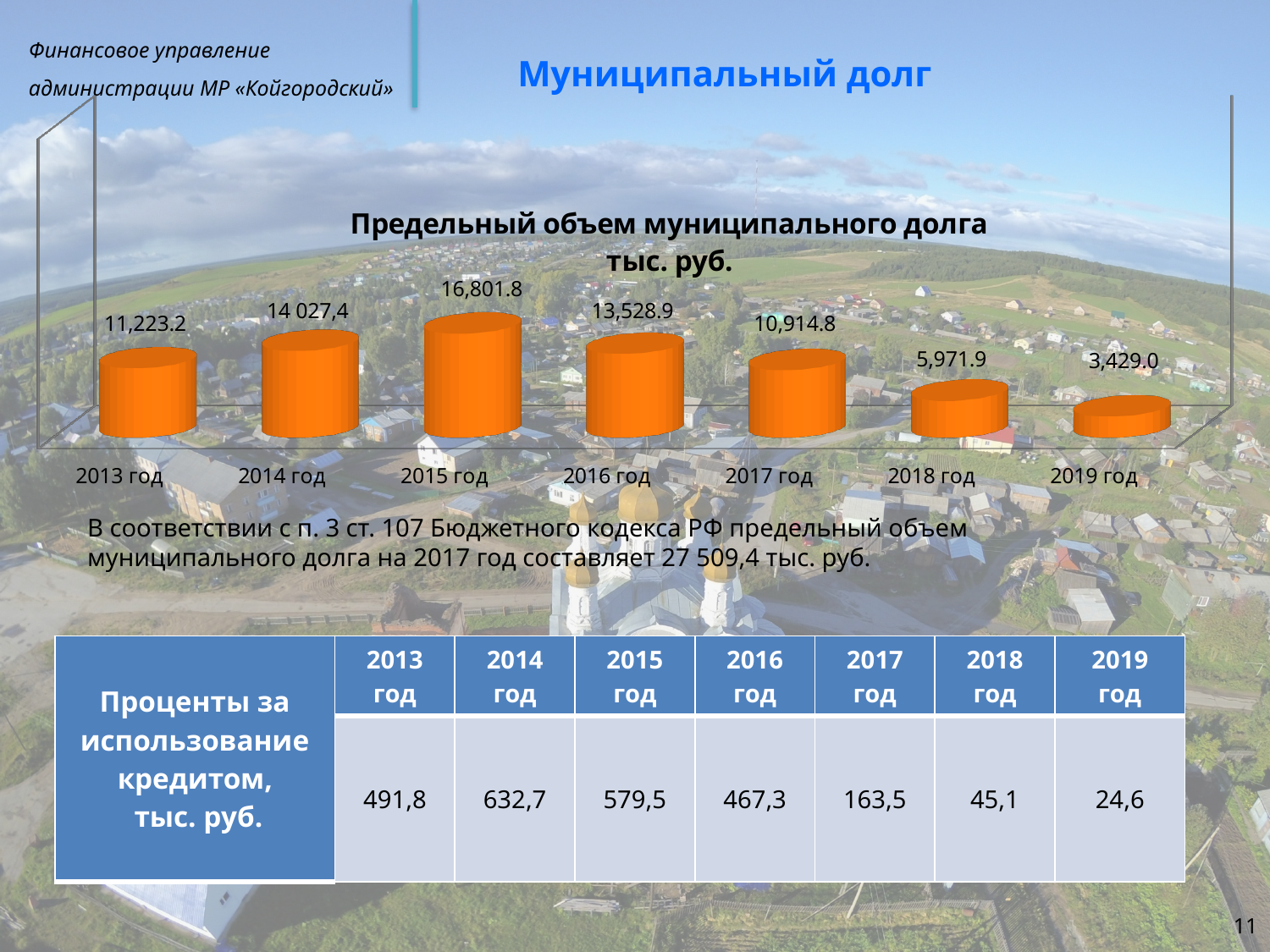
In the chart 'Предельный объем муниципального долга тыс. руб.', do the values rise or fall from 2015 год to 2019 год? Fall How many years (categories) are shown in the chart 'Предельный объем муниципального долга тыс. руб.'? 7 Which year has the highest value in the chart 'Предельный объем муниципального долга тыс. руб.'? 2015 год What is the value for 2019 год in the chart 'Предельный объем муниципального долга тыс. руб.'? 3,429.0 In the chart 'Предельный объем муниципального долга тыс. руб.', what is the difference between the values for 2015 год and 2019 год? 13,372.8 In the chart 'Предельный объем муниципального долга тыс. руб.', which is larger: the value for 2016 год or the value for 2017 год? 2016 год Which year has the lowest value in the chart 'Предельный объем муниципального долга тыс. руб.'? 2019 год In the chart 'Предельный объем муниципального долга тыс. руб.', what is the difference between the values for 2018 год and 2019 год? 2,542.9 What is the value for 2017 год in the chart 'Предельный объем муниципального долга тыс. руб.'? 10,914.8 What is the value for 2015 год in the chart 'Предельный объем муниципального долга тыс. руб.'? 16,801.8 What kind of chart is 'Предельный объем муниципального долга тыс. руб.'? Bar chart What is the value for 2014 год in the chart 'Предельный объем муниципального долга тыс. руб.'? 14 027,4